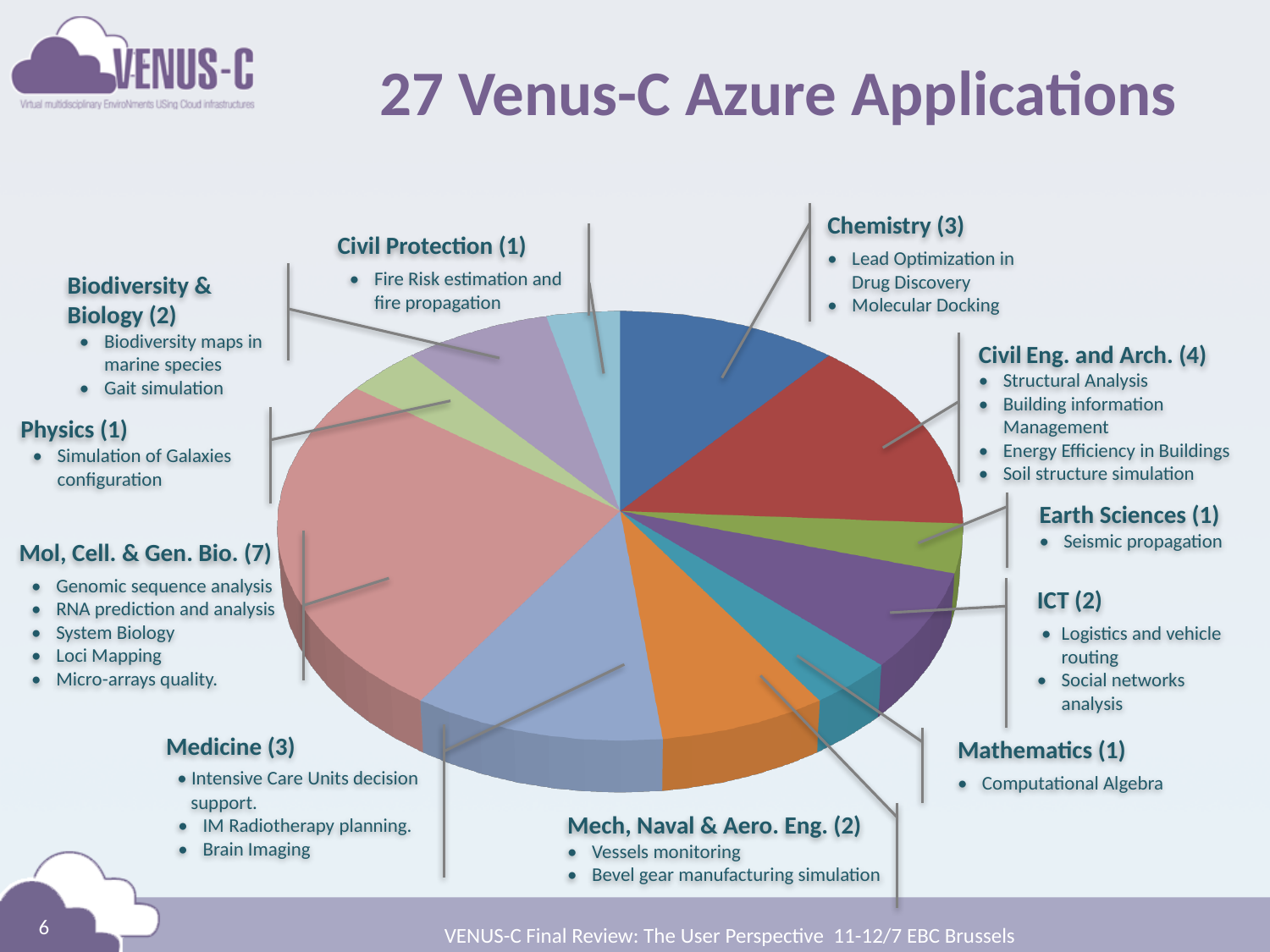
How many more applications does Mol, Cell. & Gen. Bio. have than Medicine? 4 How many categories have exactly 1 application? 4 How many applications does the Civil Eng. and Arch. category have? 4 How many categories (slices) does the pie chart have? 11 What is the difference between the number of applications in Civil Eng. and Arch. and in Chemistry? 1 What kind of chart is shown on the slide? pie chart Which category has the largest number of applications? Mol, Cell. & Gen. Bio. Which has more applications, Medicine or ICT? Medicine What is the total number of applications across all categories in the pie chart? 27 What is the title of the slide containing the pie chart? 27 Venus-C Azure Applications How many applications does the Mathematics category have? 1 How many applications does the Mol, Cell. & Gen. Bio. category have? 7